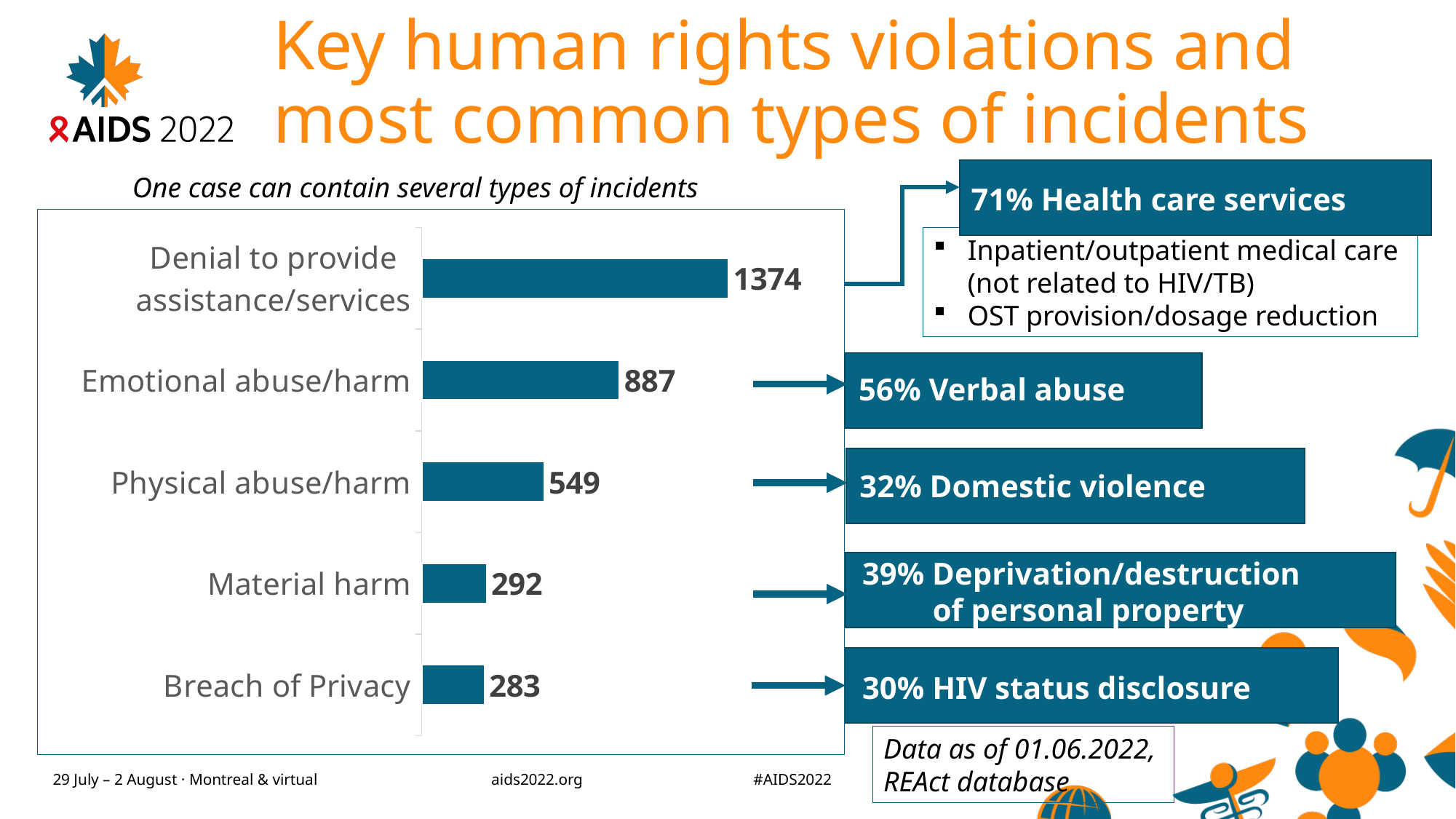
What is the value for Emotional abuse/harm? 887 What is the value for Denial to provide assistance/services? 1374 Which is larger, the value for Emotional abuse/harm or the value for Physical abuse/harm? Emotional abuse/harm What is the value for Physical abuse/harm? 549 What is the difference between the values for Denial to provide assistance/services and Emotional abuse/harm? 487 Which category has the highest value? Denial to provide assistance/services What kind of chart is shown on the slide? Bar chart Which category has the lowest value? Breach of Privacy How many categories are shown in the chart? 5 What is the value for Breach of Privacy? 283 What is the difference between the values for Physical abuse/harm and Material harm? 257 What is the value for Material harm? 292